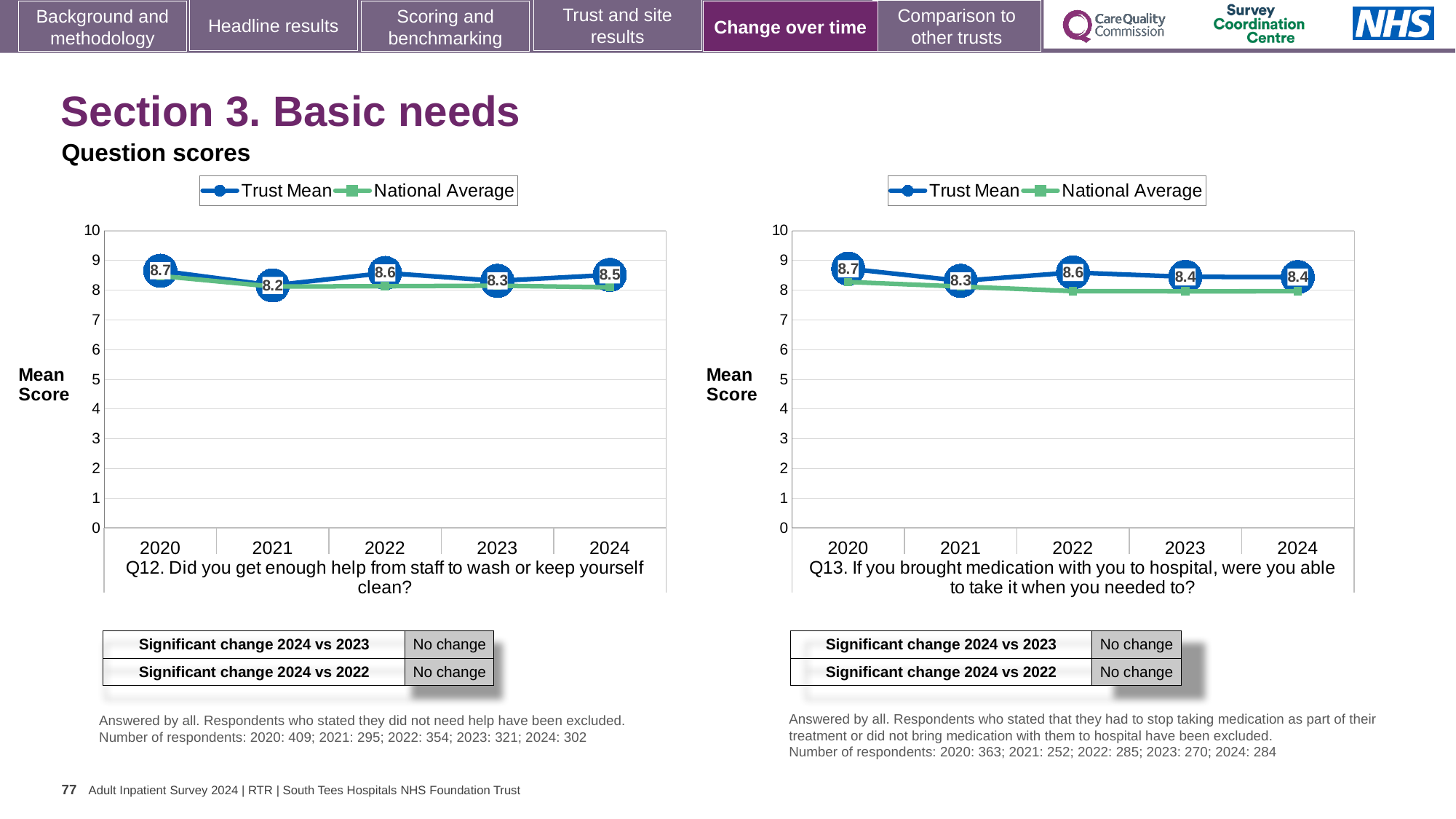
In the Q12 chart (left), which year has the lowest Trust Mean score? 2021 In the Q13 chart (right), is the National Average value for 2023 greater or less than 7? greater How many series does the legend of the Q13 chart (right) list? 2 What kind of chart is the Q12 chart (left)? Line chart In the Q12 chart (left), which is larger: the Trust Mean for 2022 or for 2023? 2022 How many years are plotted on the x axis of the Q12 chart (left)? 5 In the Q13 chart (right), what is the difference between the Trust Mean scores for 2022 and 2023? 0.2 In the Q12 chart (left), what is the Trust Mean score for 2020? 8.7 In the Q13 chart (right), which year has the highest Trust Mean score? 2020 In the Q12 chart (left), does the Trust Mean rise or fall from 2023 to 2024? Rise In the Q12 chart (left), what is the difference between the Trust Mean scores for 2020 and 2021? 0.5 In the Q13 chart (right), what is the Trust Mean score for 2023? 8.4